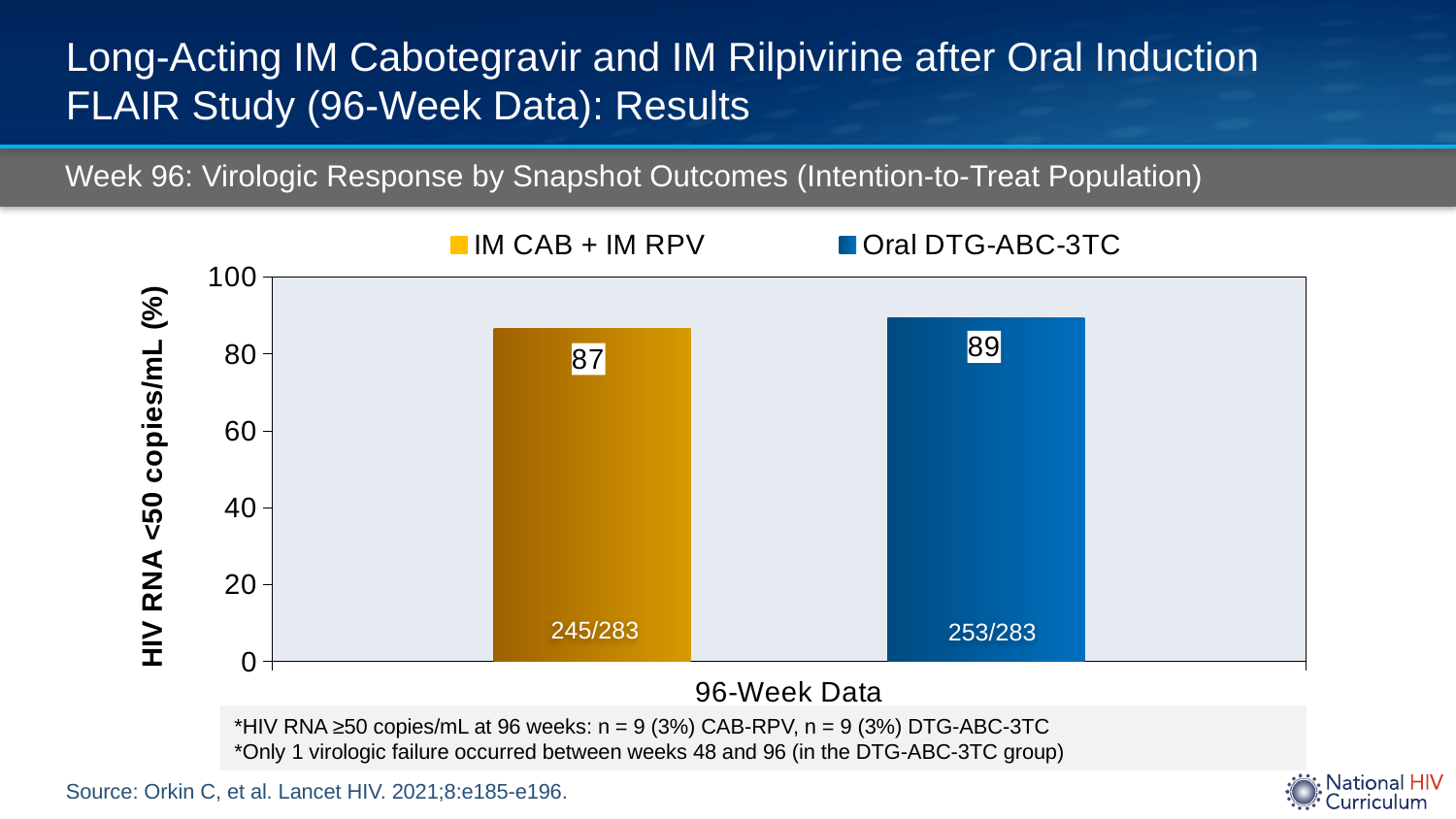
What fraction is printed inside the Oral DTG-ABC-3TC bar? 253/283 Which series has the lower value? IM CAB + IM RPV Is the value for IM CAB + IM RPV greater or less than 80? greater How many series does the legend list? 2 What kind of chart is shown? Bar chart What fraction is printed inside the IM CAB + IM RPV bar? 245/283 What is the difference between the Oral DTG-ABC-3TC value and the IM CAB + IM RPV value? 2 Is the value for Oral DTG-ABC-3TC greater or less than 100? less What is the label on the y axis? HIV RNA <50 copies/mL (%) What is the value for IM CAB + IM RPV? 87 Which series has the higher value? Oral DTG-ABC-3TC What is the value for Oral DTG-ABC-3TC? 89